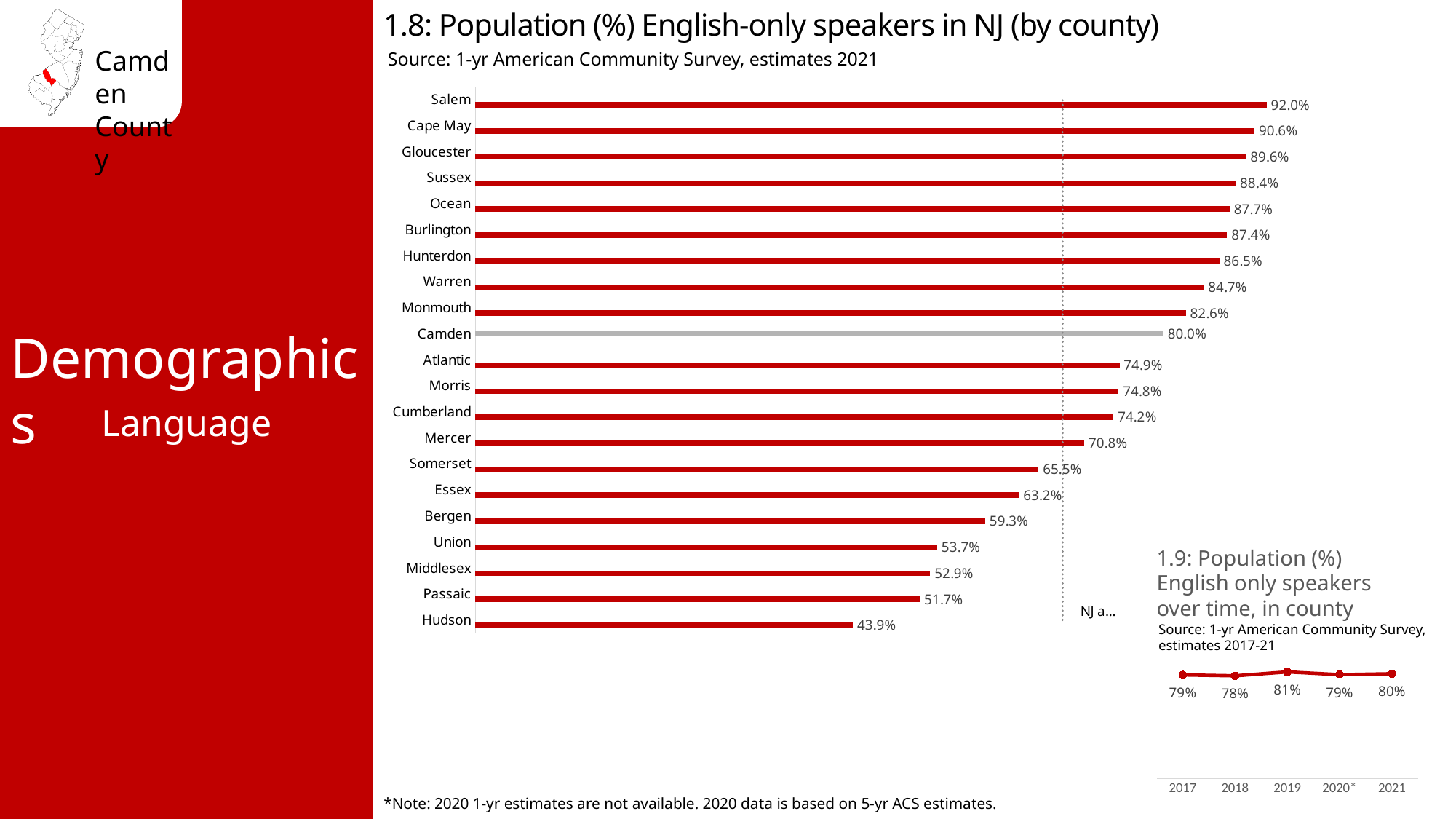
What kind of chart is chart 1.8 (English-only speakers by county)? Bar chart In chart 1.9 (English only speakers over time, in county), how many years are plotted? 5 In chart 1.8 (English-only speakers by county), what is the difference between Salem and Hudson? 48.1% In chart 1.8 (English-only speakers by county), what is the value for Camden? 80.0% In chart 1.8 (English-only speakers by county), which county has the lowest value? Hudson In chart 1.9 (English only speakers over time, in county), what is the value for 2019? 81% In chart 1.8 (English-only speakers by county), which bar is shown in grey instead of red? Camden In chart 1.8 (English-only speakers by county), what is the value for Hudson? 43.9% In chart 1.9 (English only speakers over time, in county), what is the difference between the 2019 and 2018 values? 3% In chart 1.8 (English-only speakers by county), which is larger, the value for Mercer or the value for Somerset? Mercer In chart 1.8 (English-only speakers by county), how many counties are shown? 21 In chart 1.8 (English-only speakers by county), which county has the highest value? Salem